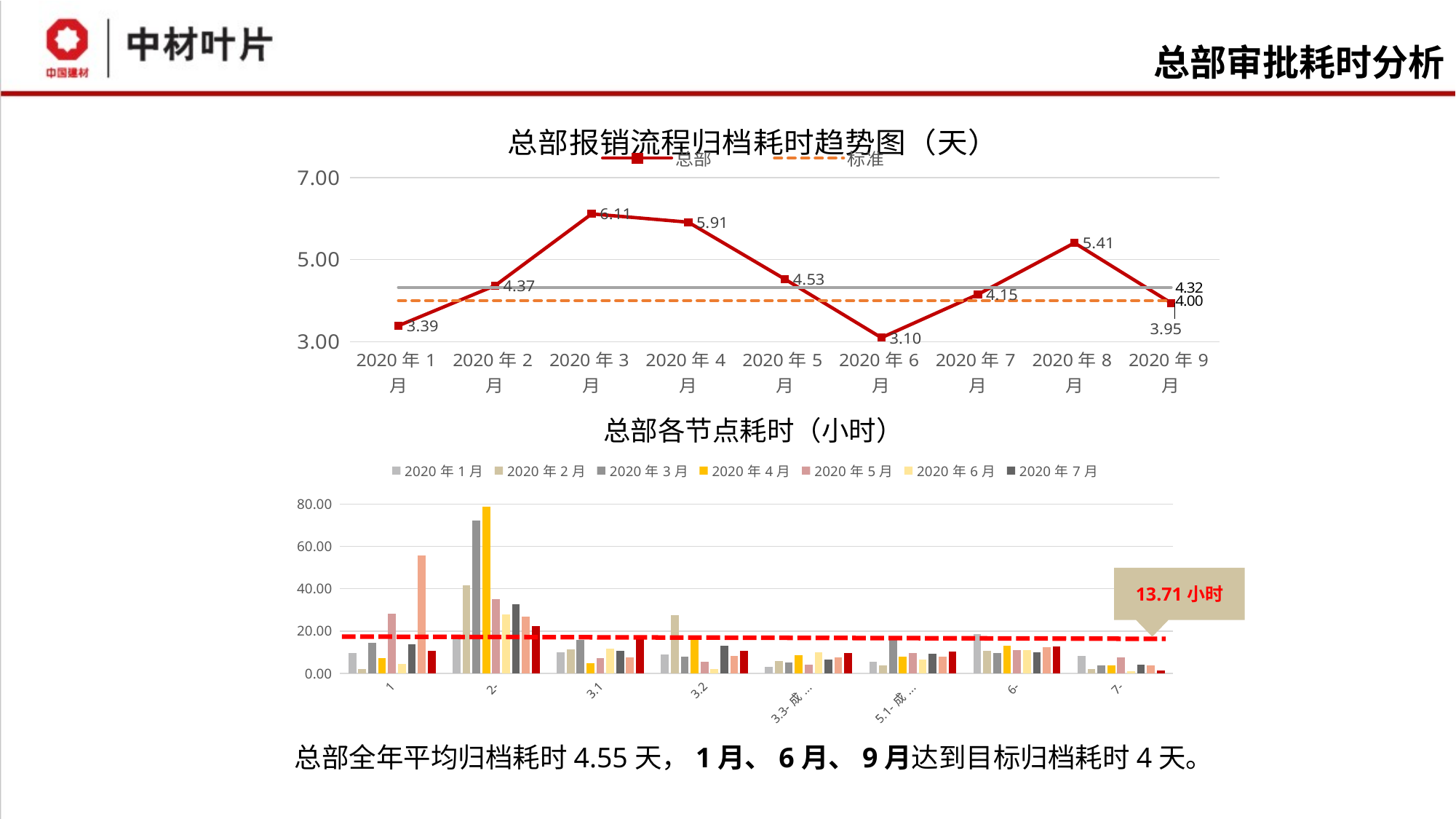
In the top chart 总部报销流程归档耗时趋势图（天）, what is the value for 2020年3月? 6.11 In the top chart 总部报销流程归档耗时趋势图（天）, which month has the highest value? 2020年3月 In the top chart 总部报销流程归档耗时趋势图（天）, how many months are plotted on the x axis? 9 In the top chart 总部报销流程归档耗时趋势图（天）, which month has the lowest value? 2020年6月 In the top chart 总部报销流程归档耗时趋势图（天）, what is the value for 2020年9月? 3.95 In the top chart 总部报销流程归档耗时趋势图（天）, what is the value for 2020年6月? 3.10 In the top chart 总部报销流程归档耗时趋势图（天）, which is larger, the value for 2020年8月 or 2020年5月? 2020年8月 In the bottom chart 总部各节点耗时（小时）, how many series does the legend list? 7 In the top chart 总部报销流程归档耗时趋势图（天）, what is the difference between the values for 2020年3月 and 2020年1月? 2.72 In the top chart 总部报销流程归档耗时趋势图（天）, what value is labelled on the dashed 标准 line? 4.00 What kind of chart is the bottom chart 总部各节点耗时（小时）? bar chart In the bottom chart 总部各节点耗时（小时）, what value is shown in the callout box? 13.71 小时